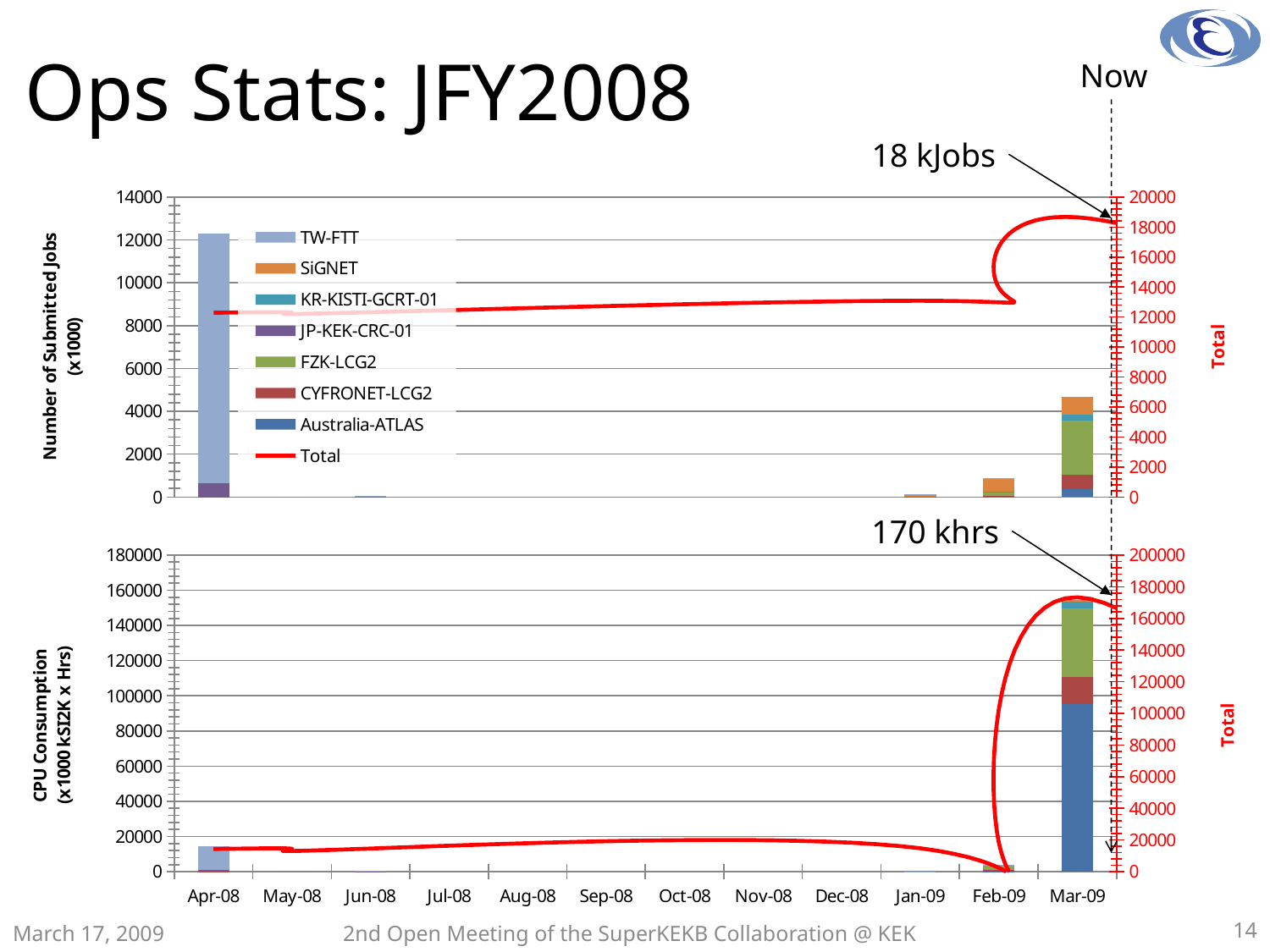
In the top chart (Number of Submitted Jobs), which month has the tallest bar? Apr-08 In the bottom chart (CPU Consumption), which bar is taller, Apr-08 or Mar-09? Mar-09 In the bottom chart (CPU Consumption), is the bar for Apr-08 greater or less than 20000? less What total value is annotated at the 'Now' line in the top chart (Number of Submitted Jobs)? 18 kJobs What total value is annotated at the 'Now' line in the bottom chart (CPU Consumption)? 170 khrs In the top chart (Number of Submitted Jobs), is the bar for Apr-08 greater or less than 10000? greater What kind of chart is the top chart on the slide? combination bar and line chart In the bottom chart (CPU Consumption), is the bar for Mar-09 greater or less than 140000? greater How many series does the legend list? 8 How many months are shown along the x axis? 12 In the bottom chart (CPU Consumption), which month has the tallest bar? Mar-09